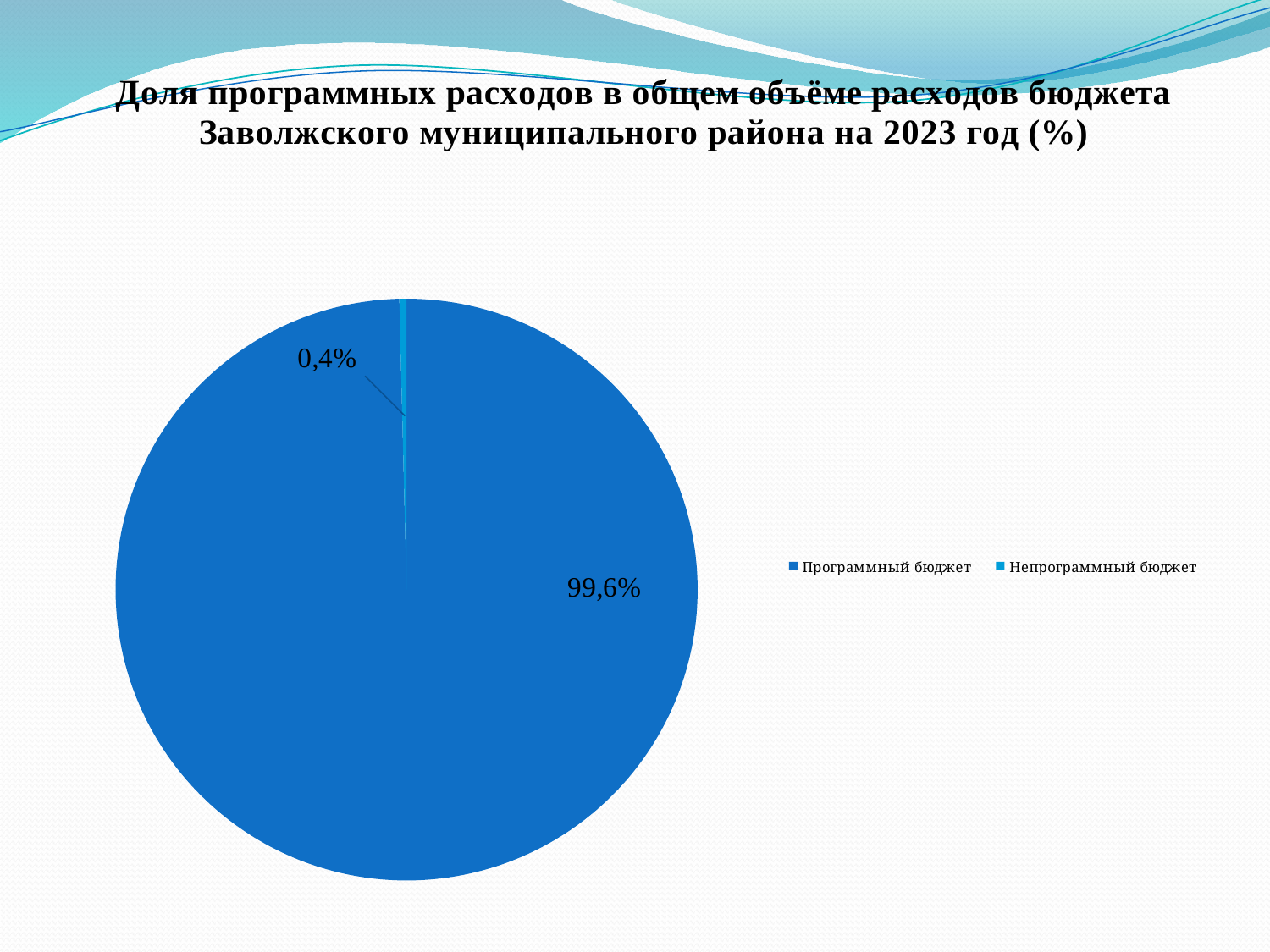
What is the value for Программный бюджет? 99,6% What is the total of the two slices shown? 100% Which is larger: Программный бюджет or Непрограммный бюджет? Программный бюджет How many slices does the pie chart have? 2 What kind of chart is shown on the slide? pie chart Which category has the largest share of the pie? Программный бюджет Which legend entry is shown in the lighter blue colour? Непрограммный бюджет What is the value for Непрограммный бюджет? 0,4% What year does the chart title refer to? 2023 Which category has the smallest share of the pie? Непрограммный бюджет What is the difference between the shares of Программный бюджет and Непрограммный бюджет? 99,2% How many entries does the legend list? 2